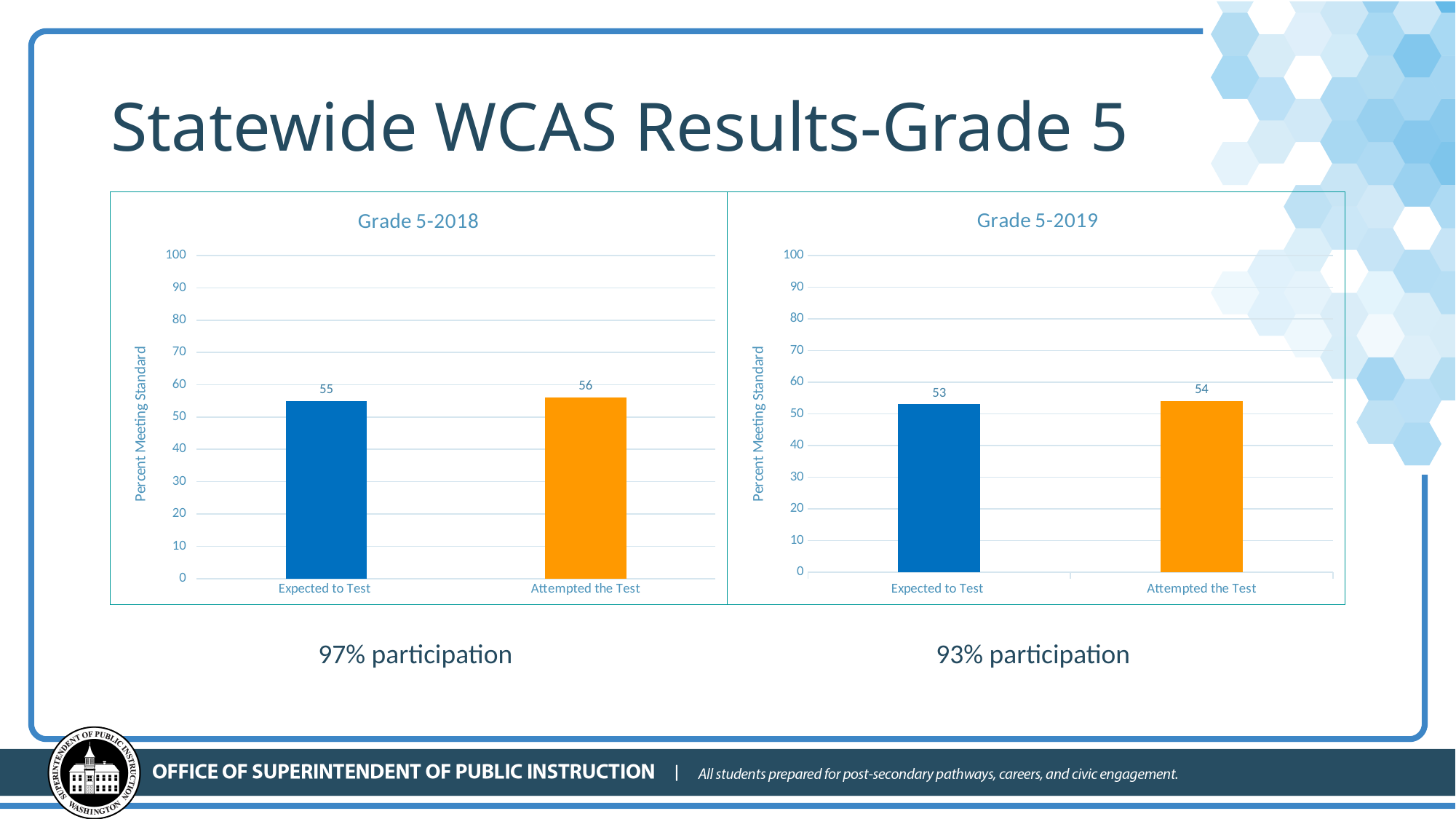
In the Grade 5-2019 chart, is the value for Expected to Test greater or less than 60? less What kind of chart is the Grade 5-2019 chart? bar chart In the Grade 5-2018 chart, what is the value for Expected to Test? 55 In the Grade 5-2019 chart, what is the difference between Attempted the Test and Expected to Test? 1 In the Grade 5-2018 chart, what is the value for Attempted the Test? 56 How many categories are shown in the Grade 5-2018 chart? 2 In the Grade 5-2018 chart, what is the difference between Attempted the Test and Expected to Test? 1 What is the title of the chart on the right side of the slide? Grade 5-2019 In the Grade 5-2018 chart, is the value for Attempted the Test greater or less than 50? greater In the Grade 5-2019 chart, what is the value for Expected to Test? 53 In the Grade 5-2019 chart, what is the value for Attempted the Test? 54 What is the y-axis label of the Grade 5-2018 chart? Percent Meeting Standard